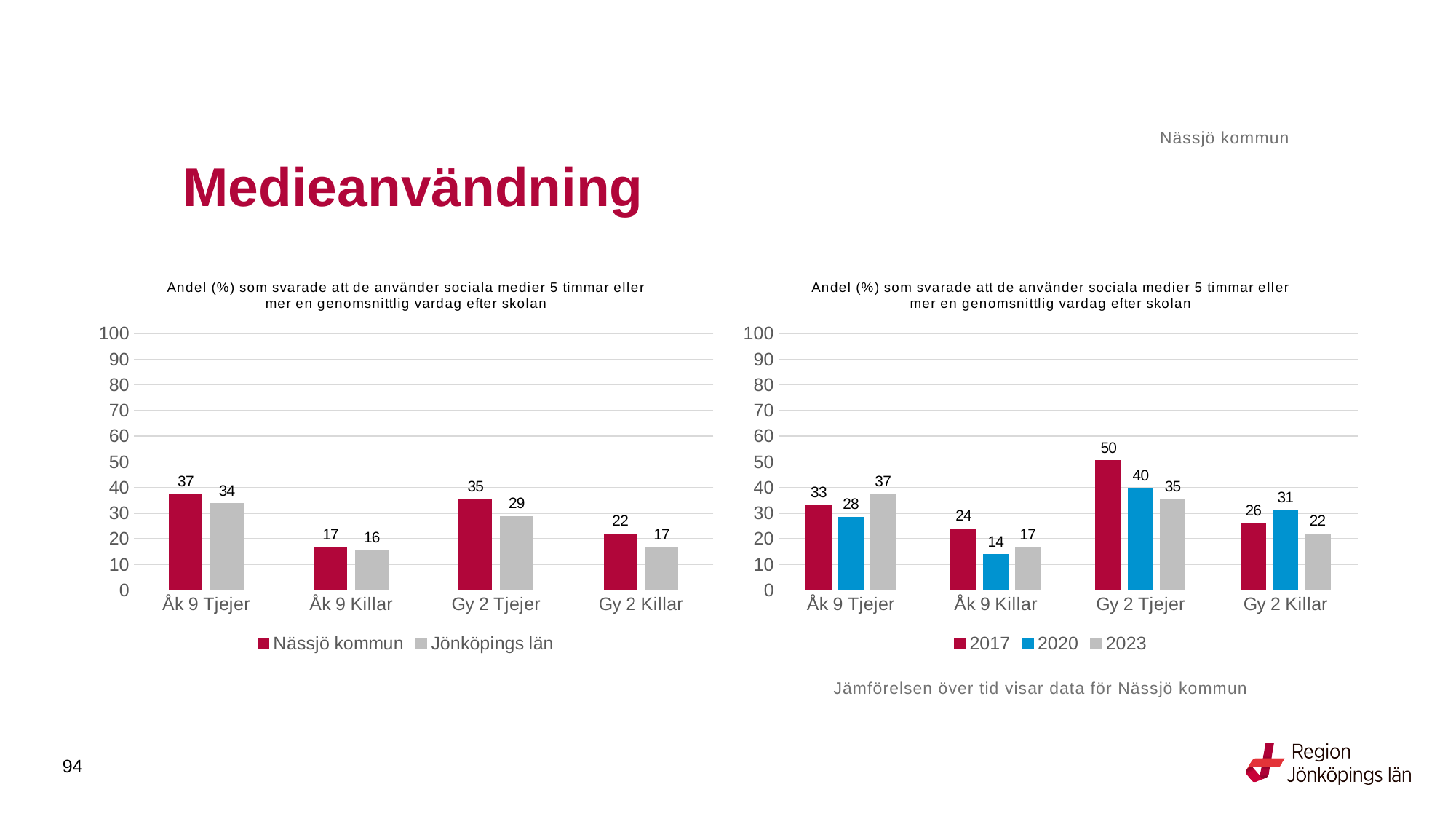
In the right chart, is the value for 2017 for Gy 2 Killar larger or smaller than the value for 2020 for Gy 2 Killar? smaller In the left chart, how many series does the legend list? 2 In the left chart, which category has the lowest value for Jönköpings län? Åk 9 Killar In the right chart, how many categories are shown on the x axis? 4 In the left chart, what is the value for Jönköpings län for Gy 2 Killar? 17 In the left chart, what is the difference between Nässjö kommun and Jönköpings län for Gy 2 Tjejer? 6 In the right chart, what is the difference between the 2017 and 2023 values for Gy 2 Tjejer? 15 In the right chart, what is the value for 2020 for Gy 2 Tjejer? 40 In the right chart, what is the value for 2023 for Åk 9 Killar? 17 What kind of chart is the right chart? Bar chart In the right chart, which category has the highest value for 2017? Gy 2 Tjejer In the left chart, what is the value for Nässjö kommun for Åk 9 Tjejer? 37